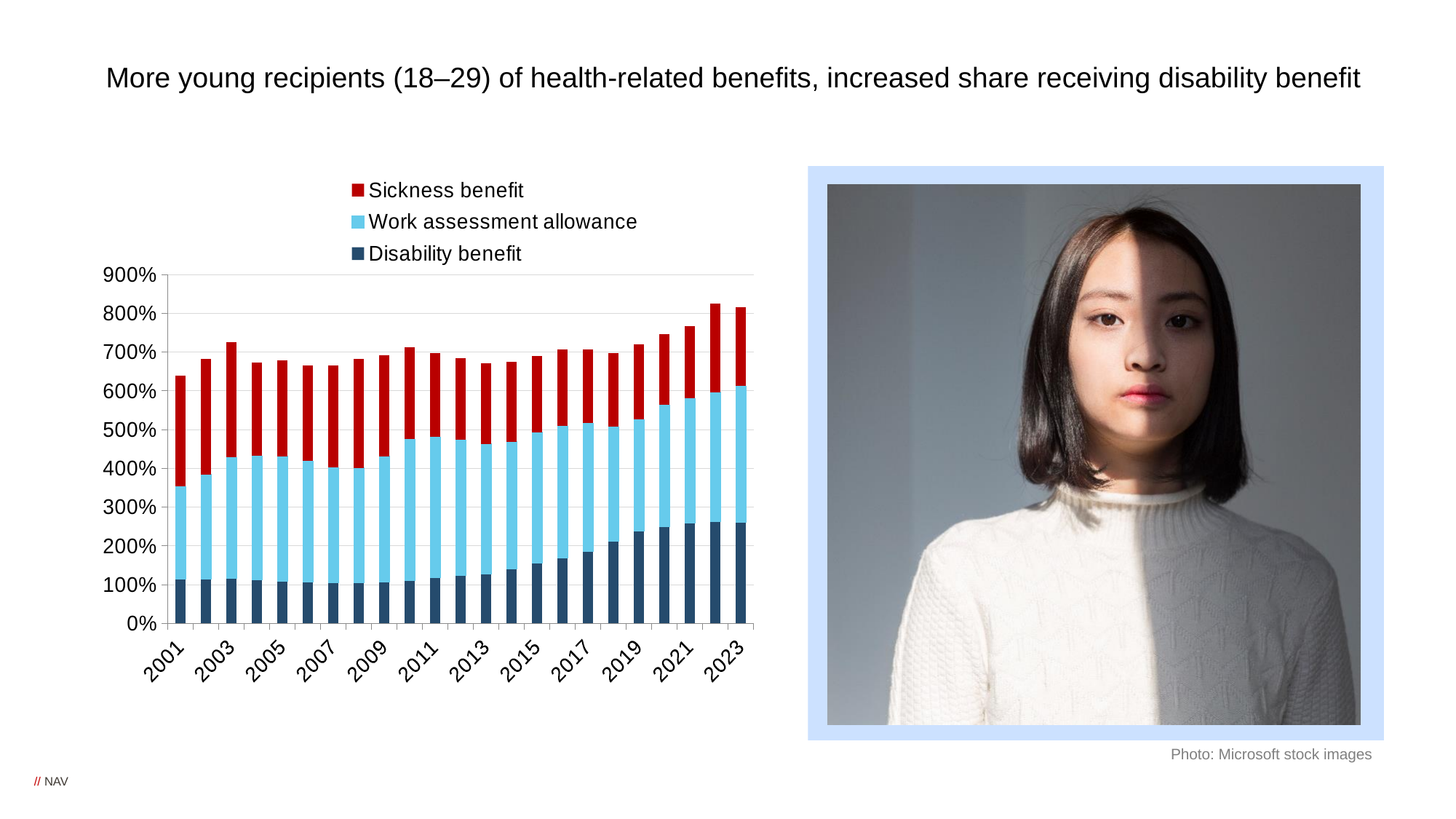
What kind of chart is shown on the slide? Stacked bar chart Which year has the larger total bar height, 2001 or 2023? 2023 Which year has the lowest total bar height? 2001 Is the total height of the bar for 2001 greater or less than 700%? less Which series is shown in dark blue at the bottom of each bar? Disability benefit How many series does the legend list? 3 How many years (bars) are plotted on the x axis? 23 Which series is shown in red in the legend? Sickness benefit Is the Disability benefit value for 2001 greater or less than 200%? less Does the Disability benefit segment generally rise or fall from 2013 to 2023? Rise Is the Disability benefit value for 2023 greater or less than 200%? greater